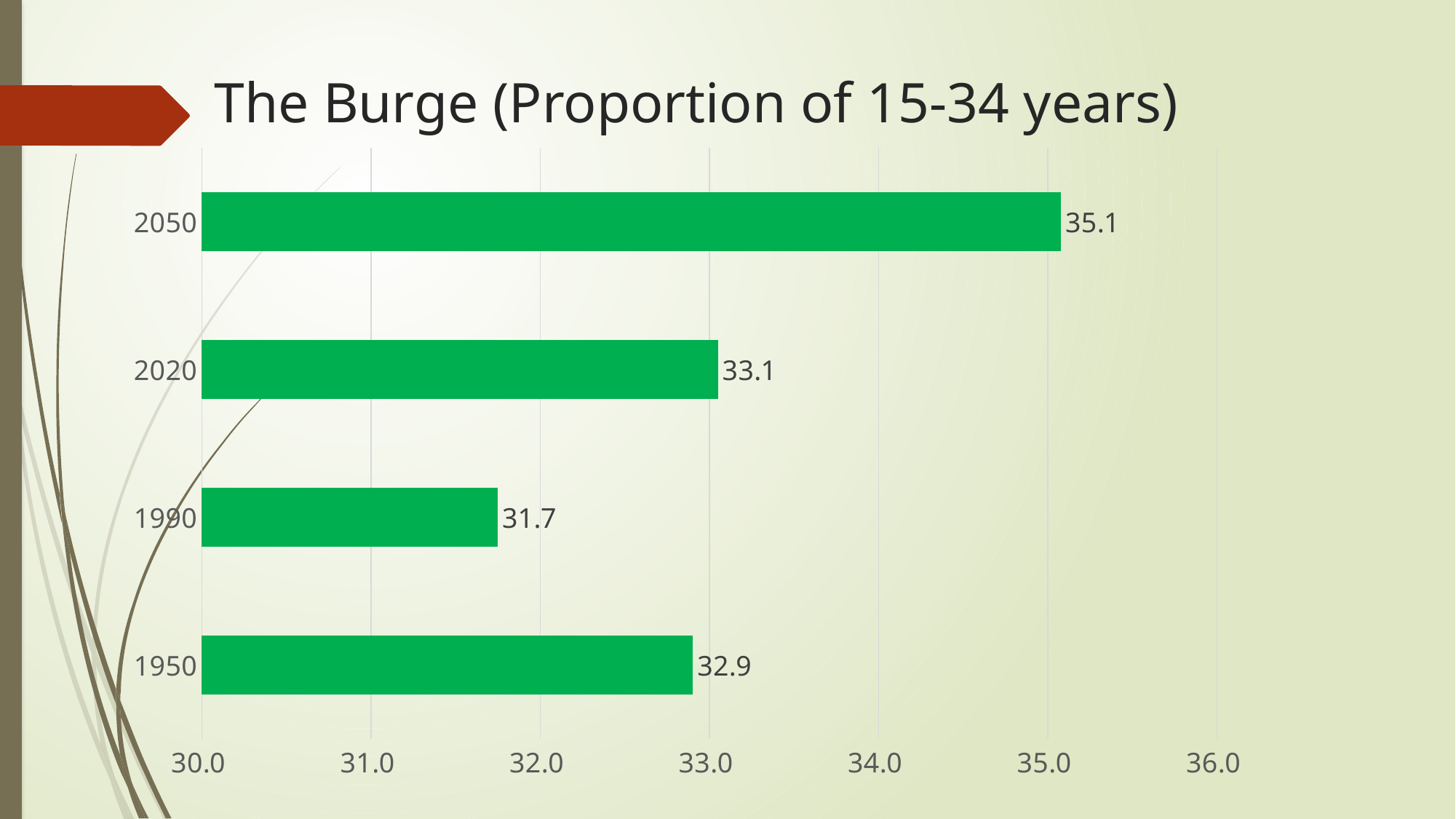
Is the value for 2020 greater or less than 34.0? less What is the value for 1950? 32.9 What is the difference between the values for 2050 and 2020? 2.0 How many years are shown in the chart? 4 What is the difference between the values for 1950 and 1990? 1.2 Which is larger, the value for 1950 or the value for 1990? 1950 What kind of chart is shown on the slide? bar chart Which year has the highest value? 2050 What is the value for 2050? 35.1 What is the value for 2020? 33.1 What is the value for 1990? 31.7 Which year has the lowest value? 1990